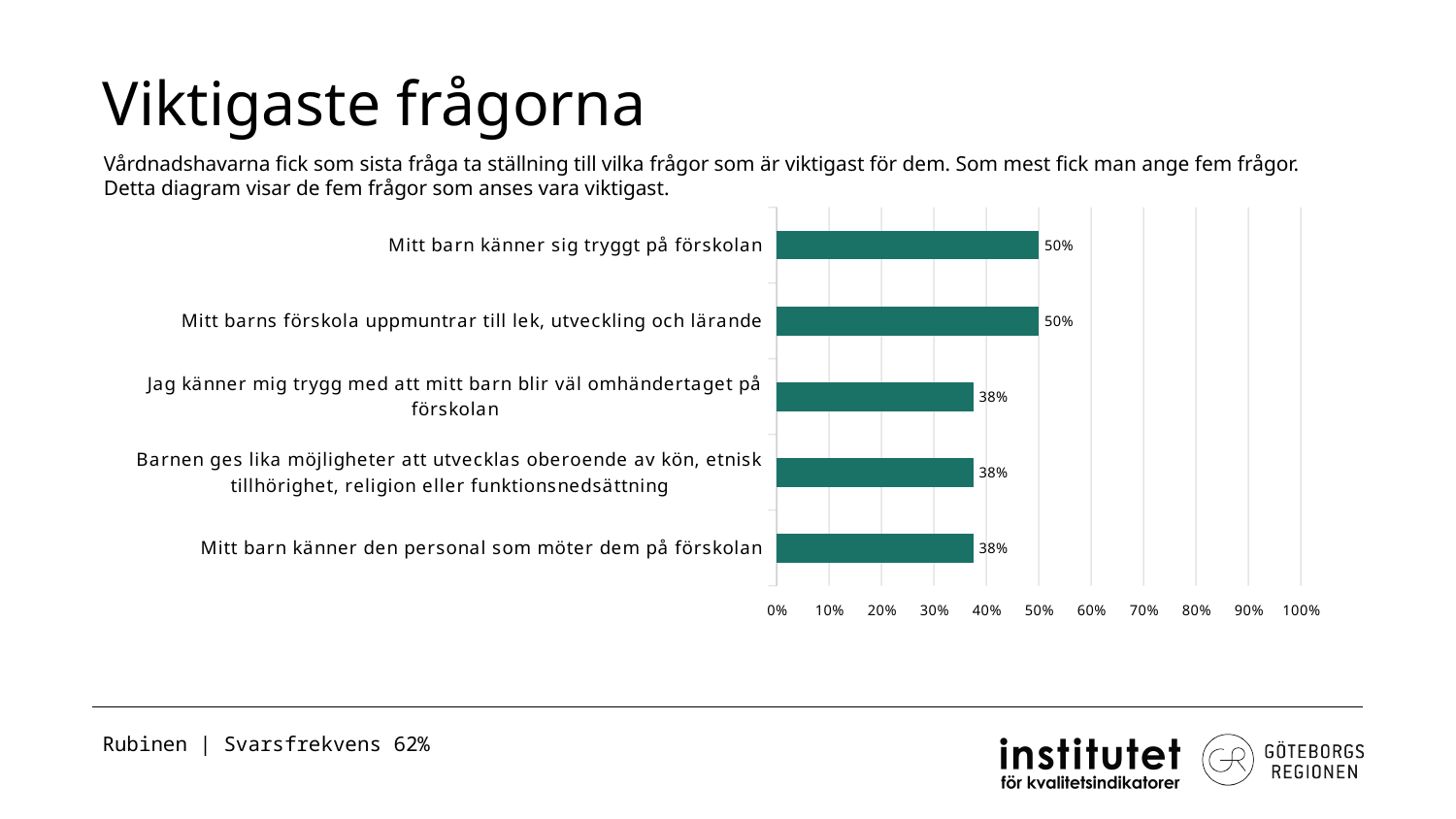
What is the title of the slide? Viktigaste frågorna Which is larger: the value for "Mitt barns förskola uppmuntrar till lek, utveckling och lärande" or the value for "Mitt barn känner den personal som möter dem på förskolan"? Mitt barns förskola uppmuntrar till lek, utveckling och lärande What is the highest value shown in the chart? 50% What kind of chart is shown on the slide? Bar chart What is the value for "Jag känner mig trygg med att mitt barn blir väl omhändertaget på förskolan"? 38% What is the value for "Mitt barn känner sig tryggt på förskolan"? 50% Is the value for "Mitt barn känner den personal som möter dem på förskolan" greater or less than 30%? greater What is the value for "Mitt barns förskola uppmuntrar till lek, utveckling och lärande"? 50% What is the value for "Mitt barn känner den personal som möter dem på förskolan"? 38% What is the difference between the value for "Mitt barn känner sig tryggt på förskolan" and the value for "Barnen ges lika möjligheter att utvecklas oberoende av kön, etnisk tillhörighet, religion eller funktionsnedsättning"? 12 percentage points How many categories are shown in the chart? 5 What is the lowest value shown in the chart? 38%